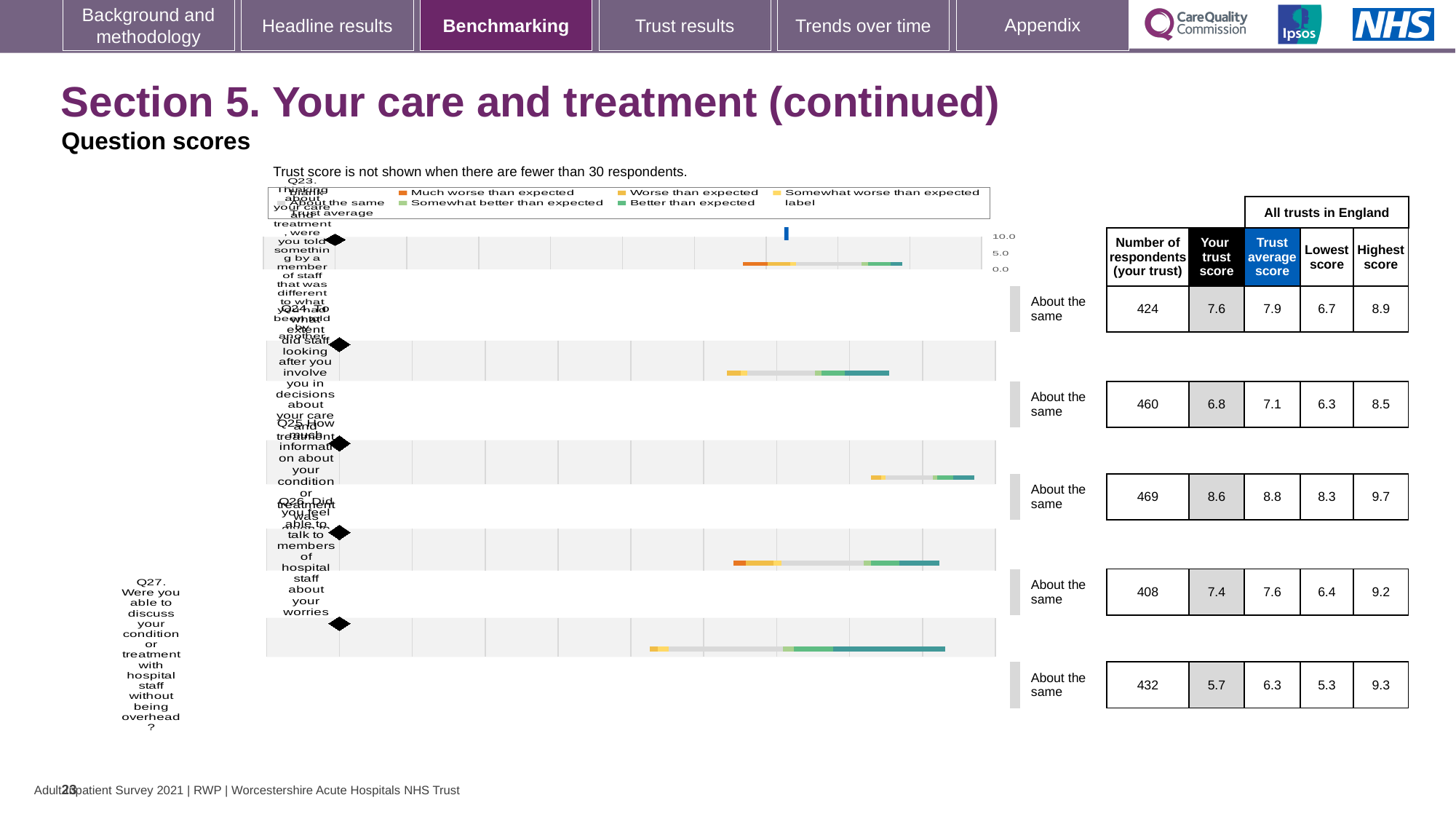
Which question has the highest trust score? Q25 How many questions (Q23 to Q27) are plotted in the chart? 5 What is the trust score for Q23? 7.6 What is the trust score for Q27 (Were you able to discuss your condition or treatment with hospital staff without being overheard?)? 5.7 What kind of chart is used to show the question scores on this slide? bar chart How many respondents answered Q24 for this trust? 460 What is the trust average score for Q27? 6.3 What benchmark category is shown for every question in the chart? About the same What is the difference between the trust scores for Q25 and Q27? 2.9 Which question has the lowest trust score? Q27 Which has the larger trust score, Q23 or Q24? Q23 What is the trust score for Q25 (How much information about your condition or treatment was given to you)? 8.6